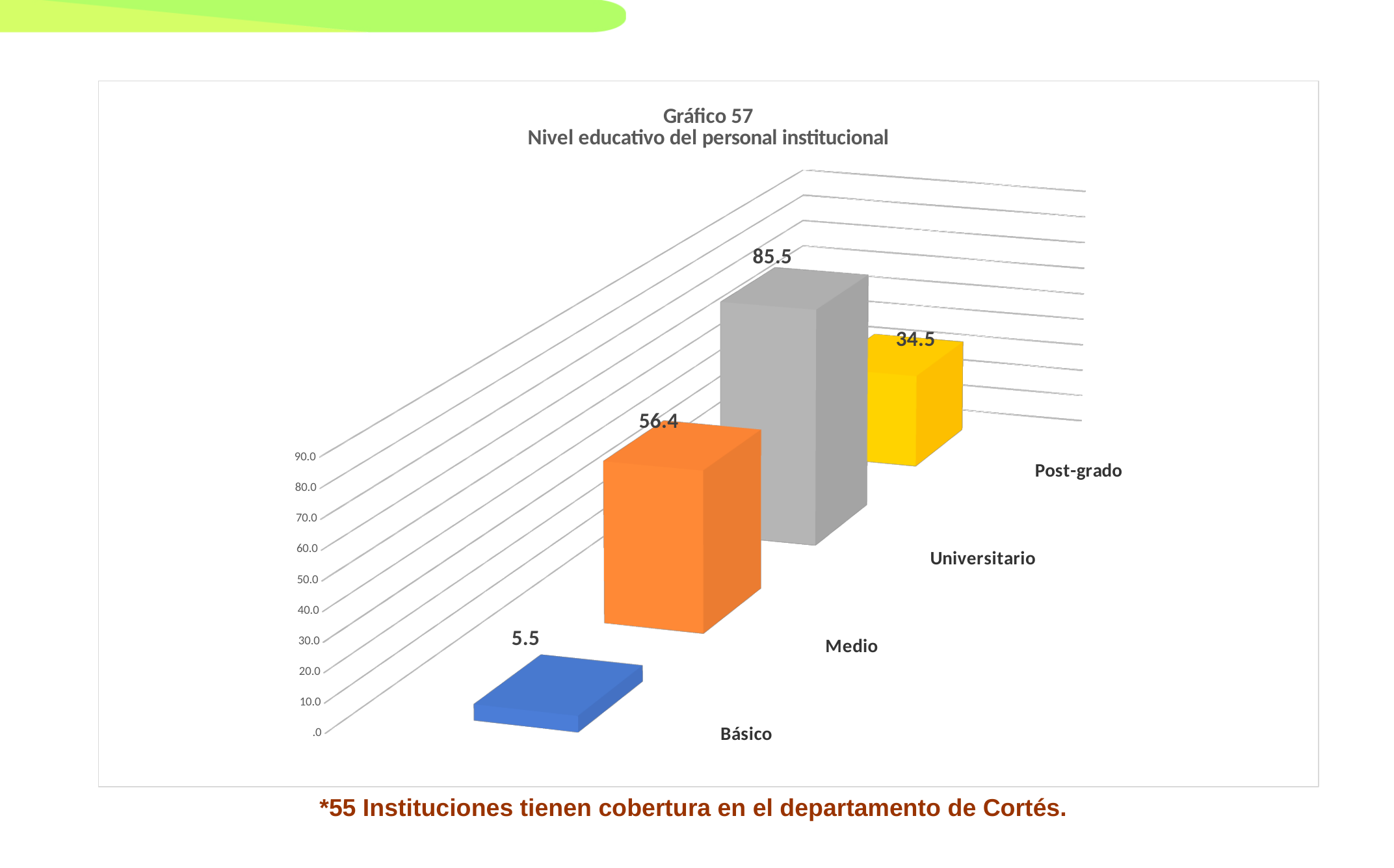
What is the difference between the values for Universitario and Medio? 29.1 What is the value for Post-grado? 34.5 Which category has the lowest value? Básico What is the difference between the values for Post-grado and Básico? 29.0 What is the value for Medio? 56.4 What is the value for Universitario? 85.5 What is the title of the chart? Gráfico 57 Nivel educativo del personal institucional Which category has the highest value? Universitario How many categories are shown in the chart? 4 Which is larger, the value for Medio or the value for Post-grado? Medio What is the value for Básico? 5.5 What kind of chart is this? Bar chart